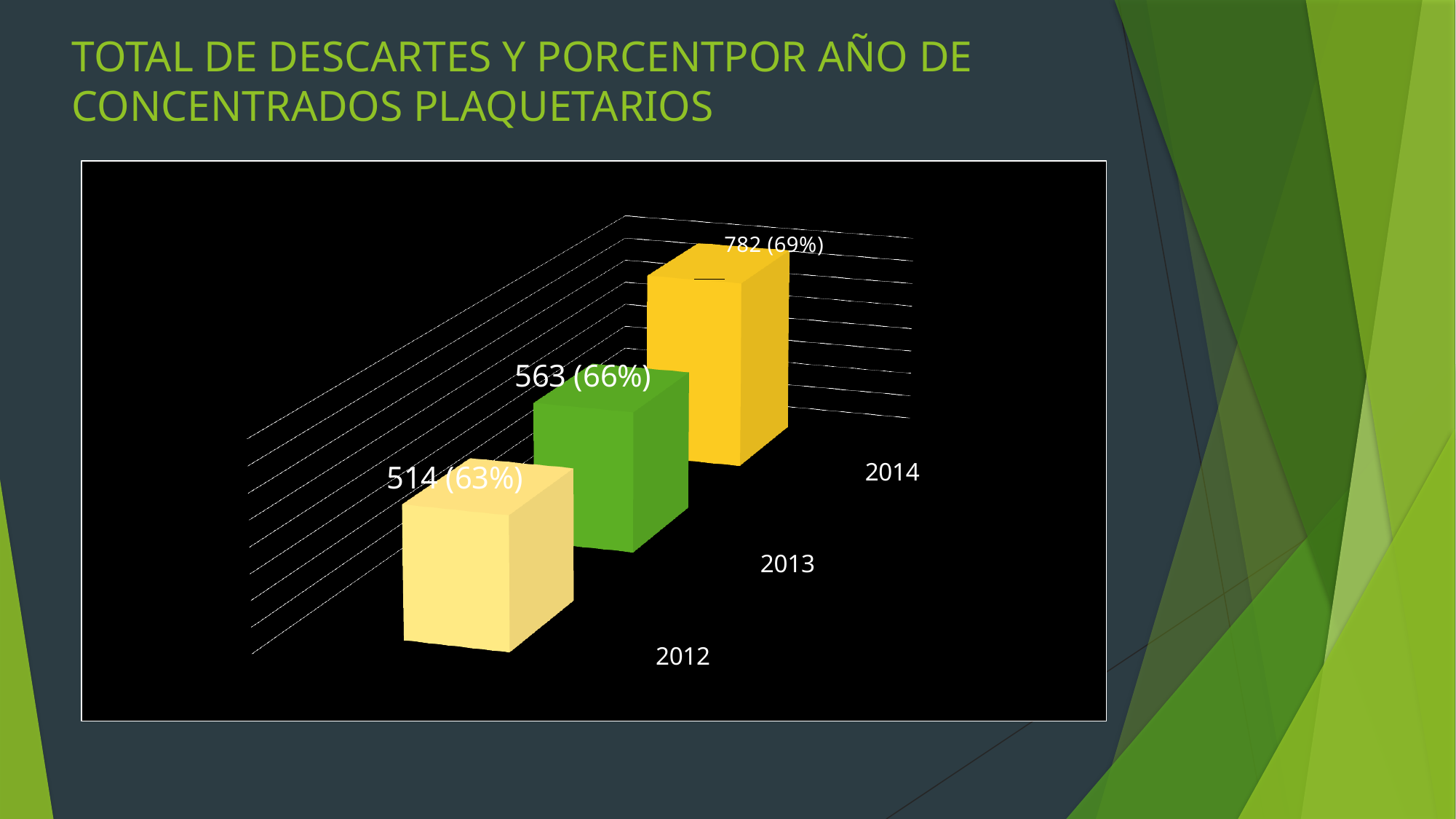
Do the values rise or fall from 2012 to 2014? Rise What is the data label shown for 2012? 514 (63%) Which year has the lowest value? 2012 Which is larger, the value for 2013 or the value for 2014? 2014 What is the difference between the 2014 total (782) and the 2012 total (514)? 268 What is the difference between the 2013 total (563) and the 2012 total (514)? 49 How many years are plotted in the chart? 3 Which year has the highest value? 2014 What is the data label shown for 2013? 563 (66%) What is the data label shown for 2014? 782 (69%) What kind of chart is shown on the slide? Bar chart What percentage is shown next to the 2014 value? 69%